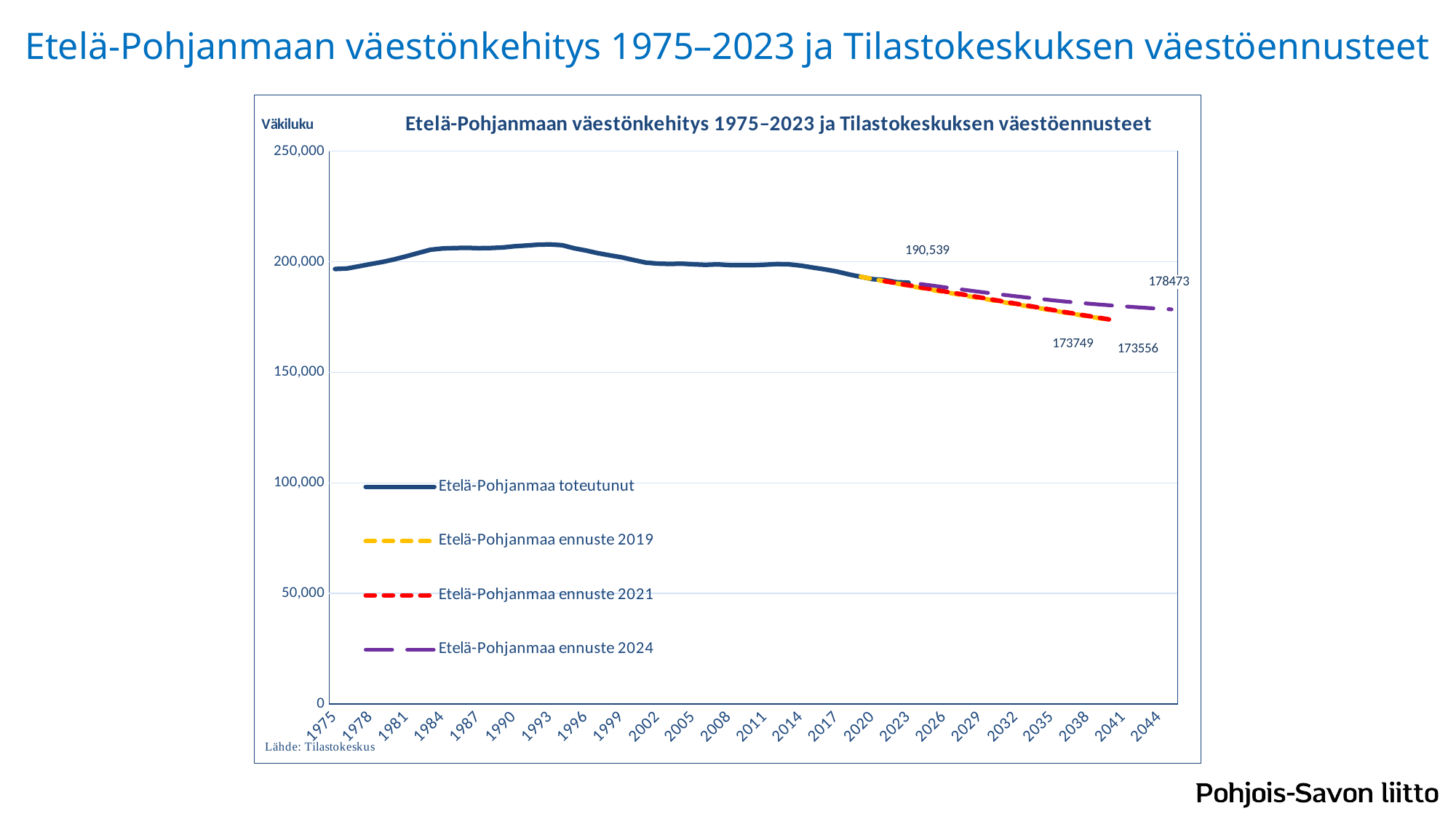
What value is labelled at the end of the Etelä-Pohjanmaa ennuste 2024 line? 178473 How many series does the legend list? 4 What is the title of the chart? Etelä-Pohjanmaan väestönkehitys 1975–2023 ja Tilastokeskuksen väestöennusteet Which forecast line ends at a higher value, Etelä-Pohjanmaa ennuste 2024 or Etelä-Pohjanmaa ennuste 2021? Etelä-Pohjanmaa ennuste 2024 What source is cited below the chart? Tilastokeskus What value is labelled near the end of the Etelä-Pohjanmaa toteutunut line? 190,539 Is the Etelä-Pohjanmaa toteutunut value for 1975 greater or less than 200,000? less What kind of chart is shown on the slide? line chart Does the Etelä-Pohjanmaa toteutunut line rise or fall between 1993 and 2023? fall Is the Etelä-Pohjanmaa ennuste 2024 value for 2044 greater or less than 150,000? greater What is the last year shown on the x axis? 2044 Is the Etelä-Pohjanmaa toteutunut value for 1993 greater or less than 200,000? greater